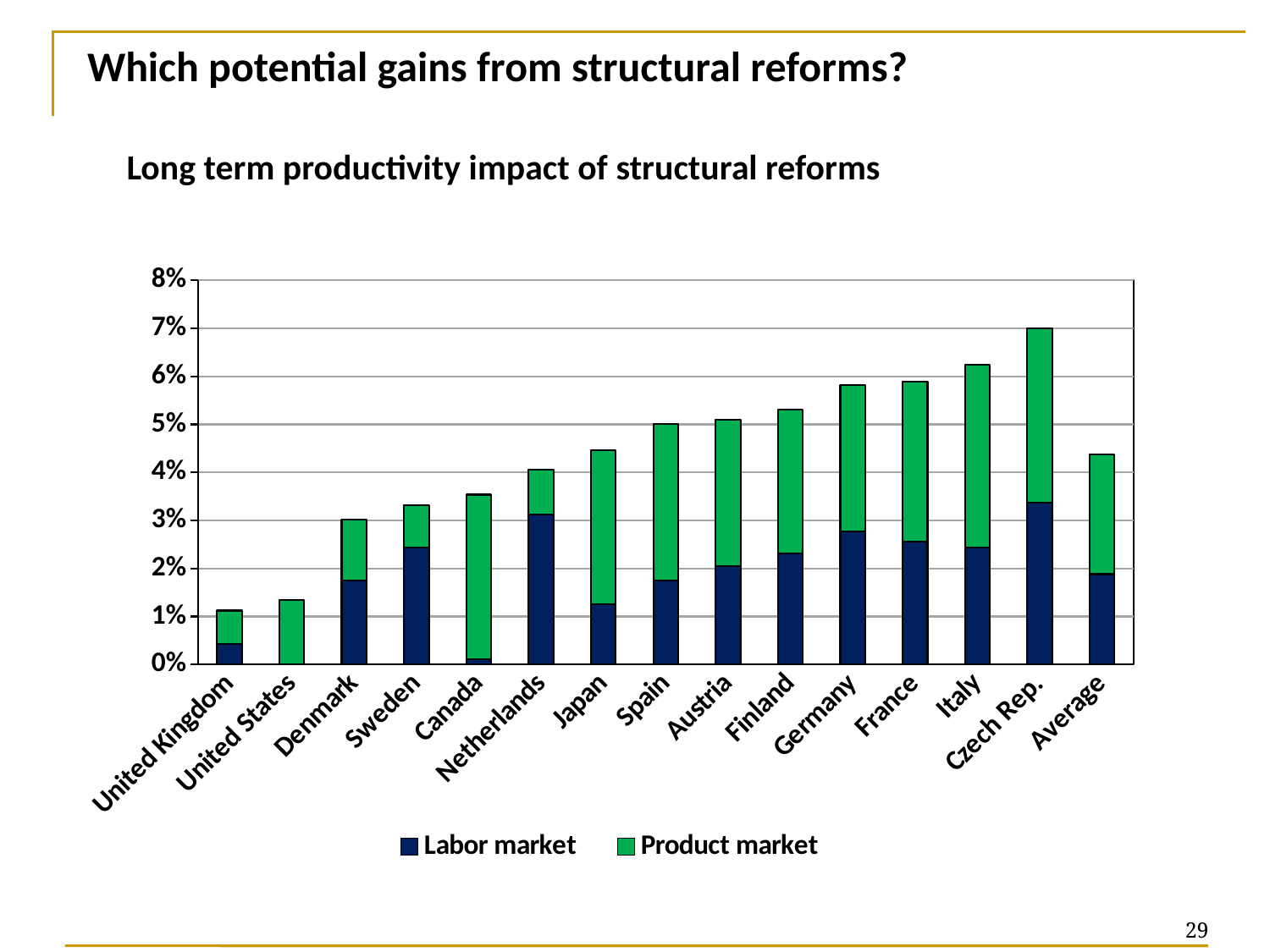
Do the total bar heights generally rise or fall from United Kingdom to Czech Rep.? rise Is the total value for Germany greater or less than 5%? greater How many series does the legend list? 2 Is the Labor market value for Canada greater or less than 1%? less Which category has the highest total bar? Czech Rep. For Canada, which is larger: the Labor market segment or the Product market segment? Product market Which country shows no Labor market segment at all? United States How many categories are shown on the x axis? 15 Is the total value for Average greater or less than 4%? greater Which category has the lowest total bar? United Kingdom What kind of chart is shown on the slide? Stacked bar chart